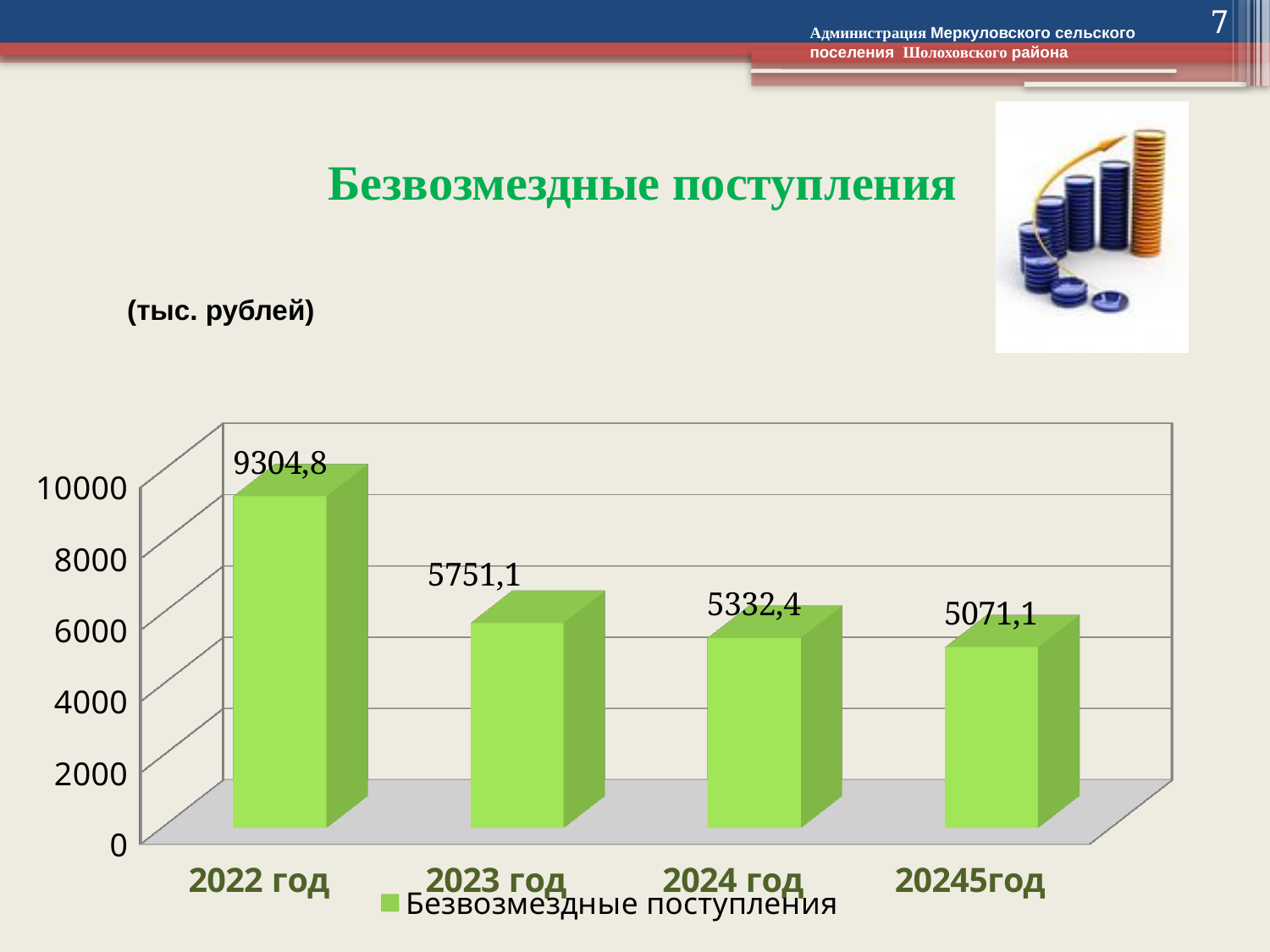
What is the value for the last category, labelled 20245год? 5071,1 Do the values rise or fall from left to right along the x axis? Fall What is the value for 2023 год? 5751,1 What kind of chart is shown on the slide? Bar chart What is the value for 2022 год? 9304,8 What is the difference between the values for 2022 год and 2023 год? 3553,7 Which category has the lowest value? 20245год What is the value for 2024 год? 5332,4 How many categories are shown on the x axis? 4 Which is larger, the value for 2024 год or the value for 2023 год? 2023 год Which year has the highest value? 2022 год What is the difference between the values for 2023 год and 2024 год? 418,7